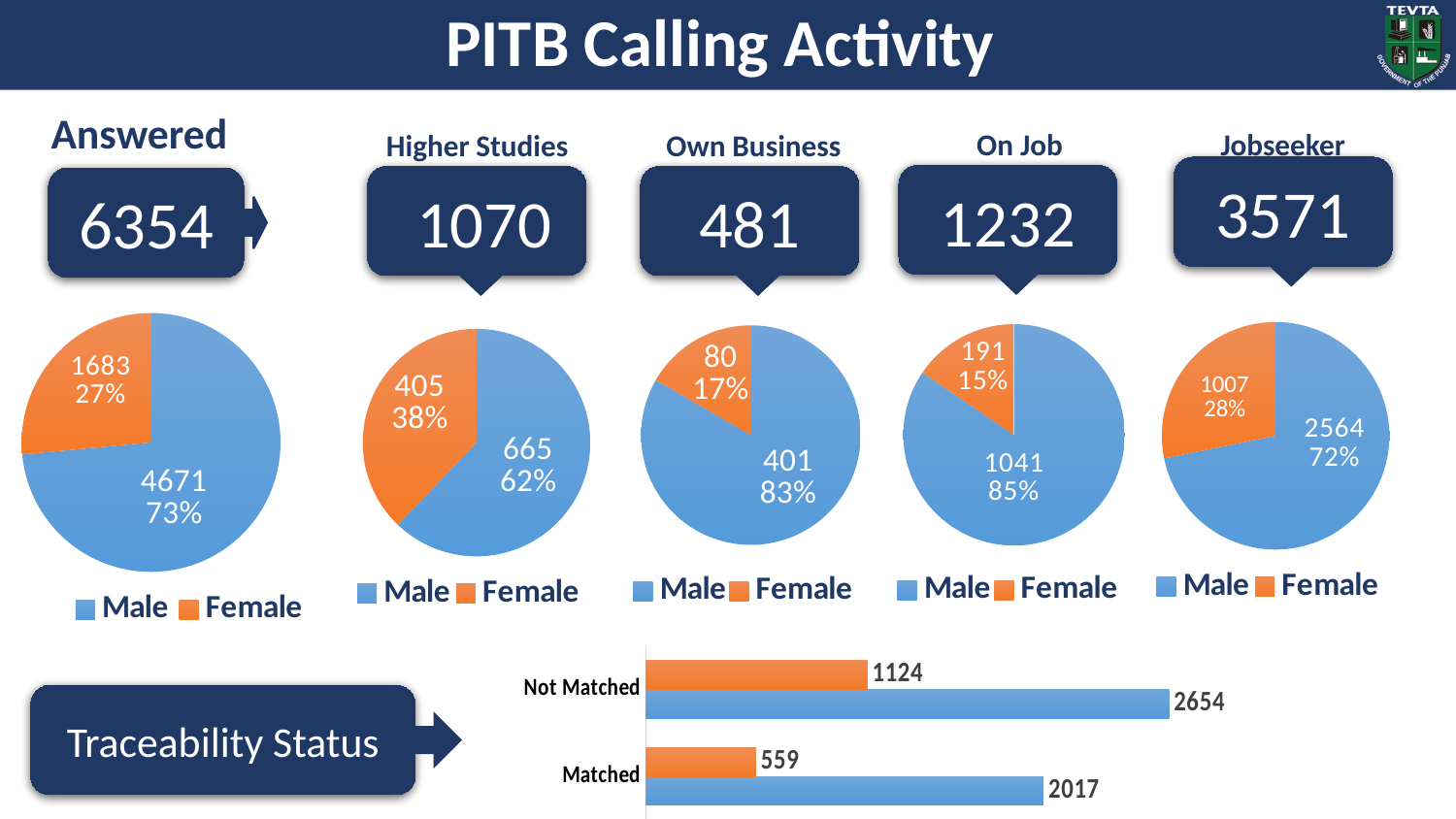
In the Own Business pie chart, what share of the pie is Male? 83% In the Traceability Status bar chart, what is the difference between the orange bars for Not Matched and Matched? 565 In the Jobseeker pie chart, what is the value for Male? 2564 In the On Job pie chart, what is the value for Female? 191 How many series does the legend of the Own Business pie chart list? 2 What kind of chart is the Traceability Status chart at the bottom of the slide? Bar chart In the Higher Studies pie chart, what is the difference between the Male and Female values? 260 In the Answered pie chart, what is the value for Male? 4671 In the Higher Studies pie chart, what is the value for Female? 405 In the Traceability Status bar chart, what is the value of the blue bar for Not Matched? 2654 In the Answered pie chart, what share of the pie is Female? 27% In the Jobseeker pie chart, which is larger, Male or Female? Male